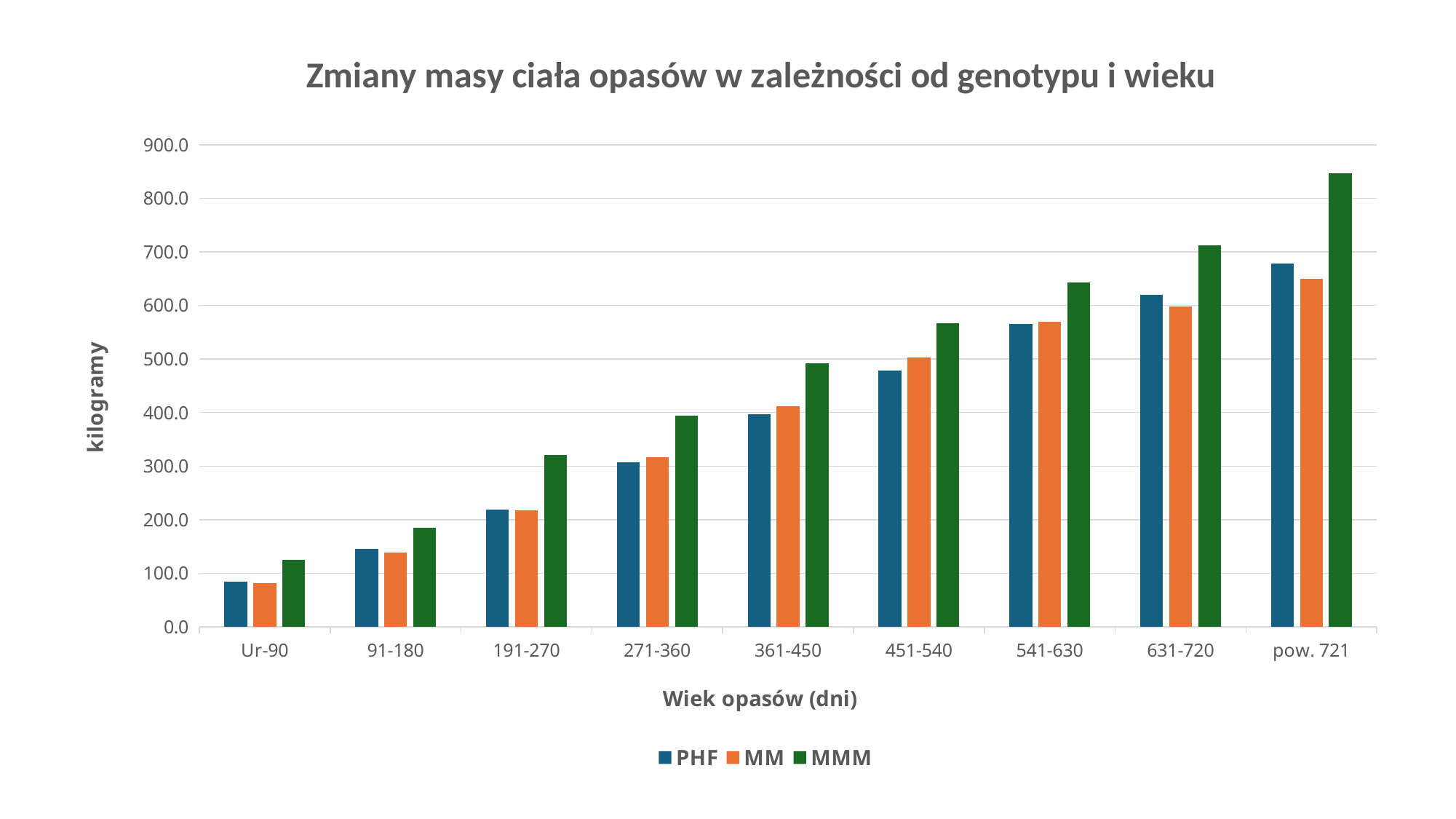
What is the title of the y axis? kilogramy How many series does the legend list? 3 Is the MMM value for 541-630 greater or less than 600? greater For the pow. 721 age group, which is larger: PHF or MM? PHF For the 631-720 age group, which is larger: PHF or MM? PHF Do the MMM values rise or fall as age increases along the x axis? rise What kind of chart is shown on the slide? bar chart How many age groups (categories) are shown on the x axis? 9 For which age group is the PHF value lowest? Ur-90 For which age group is the MMM value highest? pow. 721 Is the PHF value for 451-540 greater or less than 500? less Is the MMM value for pow. 721 greater or less than 800? greater